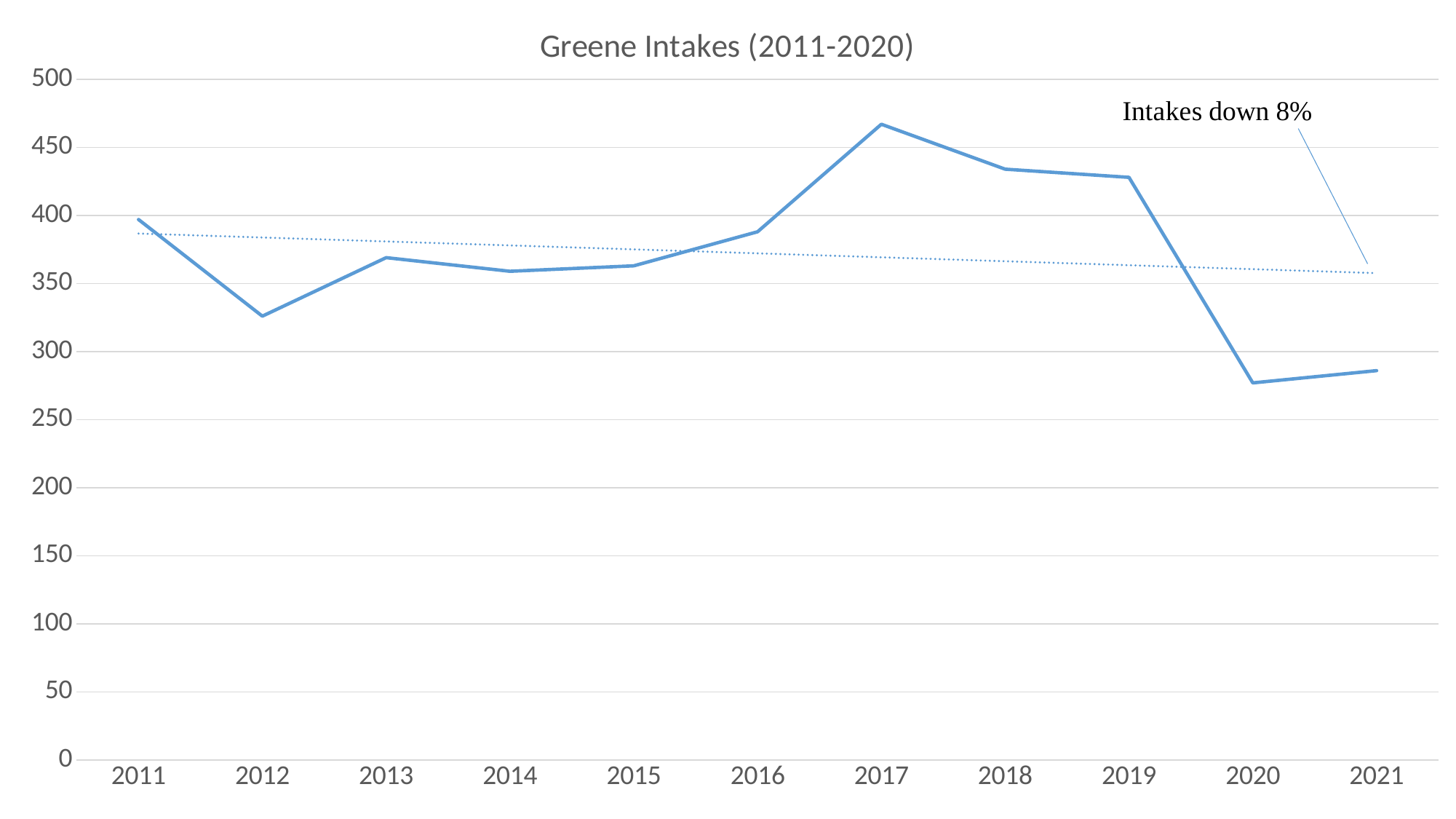
Is the value for 2020 greater or less than 300? less Is the value for 2019 greater or less than 400? greater Is the value for 2017 greater or less than 450? greater How many years are plotted along the x axis of the chart? 11 Do the values rise or fall from 2019 to 2020? fall Which year has the larger value, 2011 or 2012? 2011 Which year has the highest intake value on the chart? 2017 What is the title of the chart? Greene Intakes (2011-2020) What does the text annotation on the chart say? Intakes down 8% What kind of chart is shown on the slide? line chart Which year has the lowest intake value on the chart? 2020